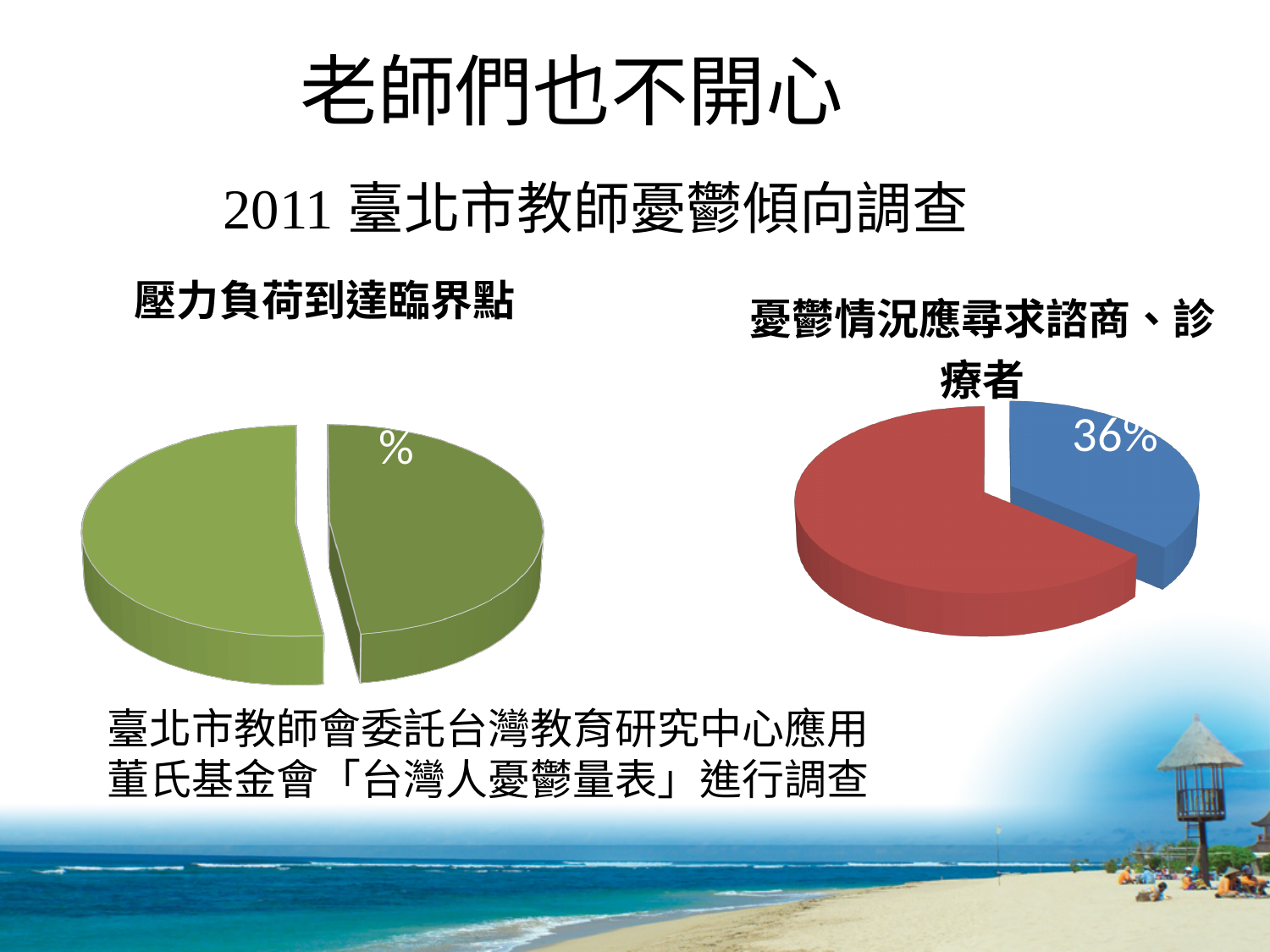
In the chart titled 憂鬱情況應尋求諮商、診療者, is the blue slice's share greater or less than 50%? less What colours are the two slices of the pie chart on the right of the slide? red and blue In the chart titled 憂鬱情況應尋求諮商、診療者, which slice is larger, the red one or the blue one? the red one What is the title of the pie chart on the left of the slide? 壓力負荷到達臨界點 How many slices does the chart titled 憂鬱情況應尋求諮商、診療者 have? 2 How many slices does the chart titled 壓力負荷到達臨界點 have? 2 What kind of chart is the chart titled 憂鬱情況應尋求諮商、診療者? pie chart What kind of chart is the chart titled 壓力負荷到達臨界點? pie chart How many pie charts are shown on the slide? 2 In the chart titled 憂鬱情況應尋求諮商、診療者, what percentage is shown on the blue slice? 36%